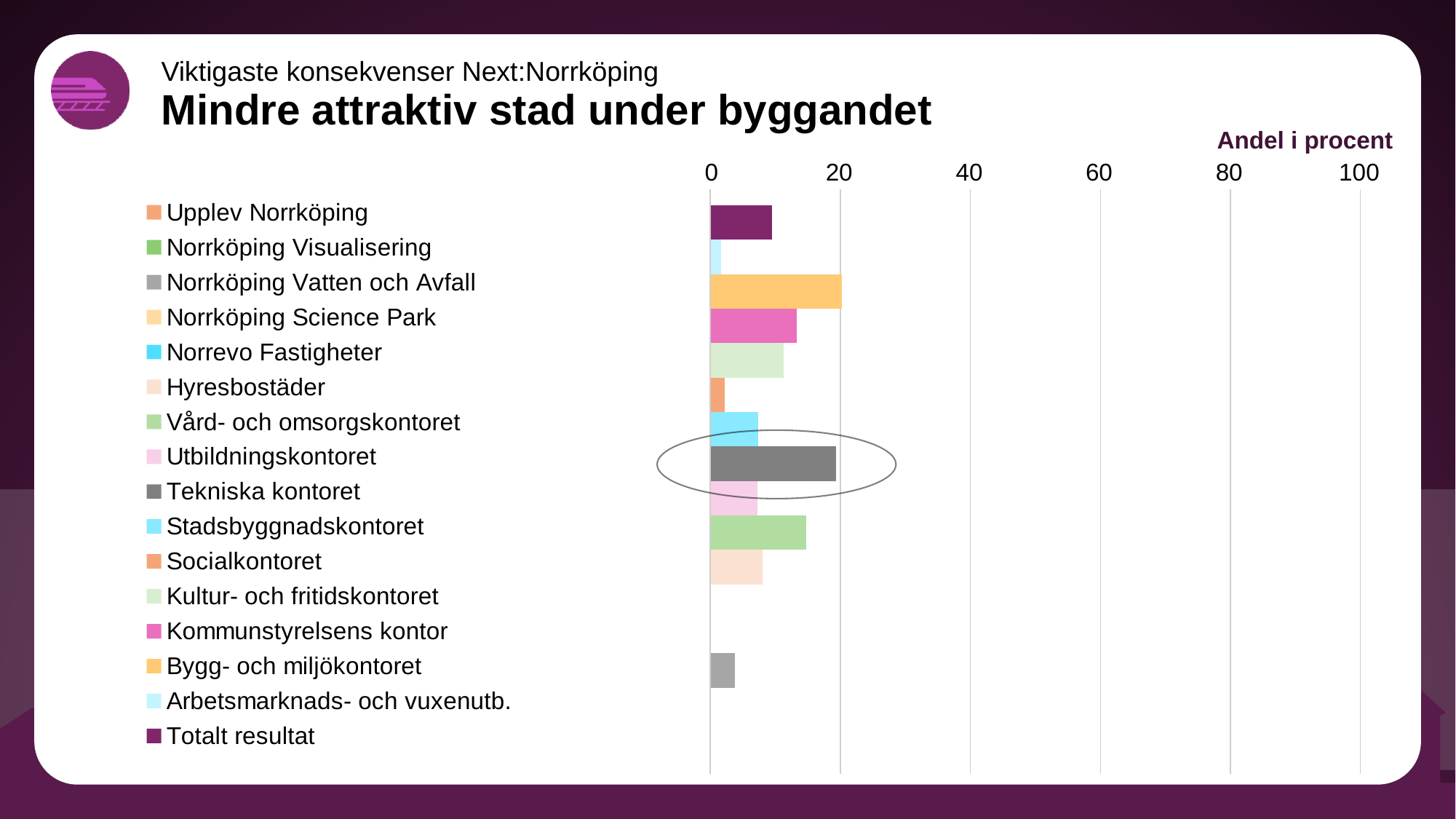
Is the value for Tekniska kontoret greater or less than 10? greater What kind of chart is shown on the slide? bar chart What is the title of the chart on the slide? Mindre attraktiv stad under byggandet Which is larger, the value for Vård- och omsorgskontoret or the value for Hyresbostäder? Vård- och omsorgskontoret Which is larger, the value for Tekniska kontoret or the value for Socialkontoret? Tekniska kontoret Which is larger, the value for Kommunstyrelsens kontor or the value for Stadsbyggnadskontoret? Kommunstyrelsens kontor Is the value for Totalt resultat greater or less than 20? less Is the value for Vård- och omsorgskontoret greater or less than 10? greater How many series does the legend list? 16 What label is shown above the horizontal axis? Andel i procent